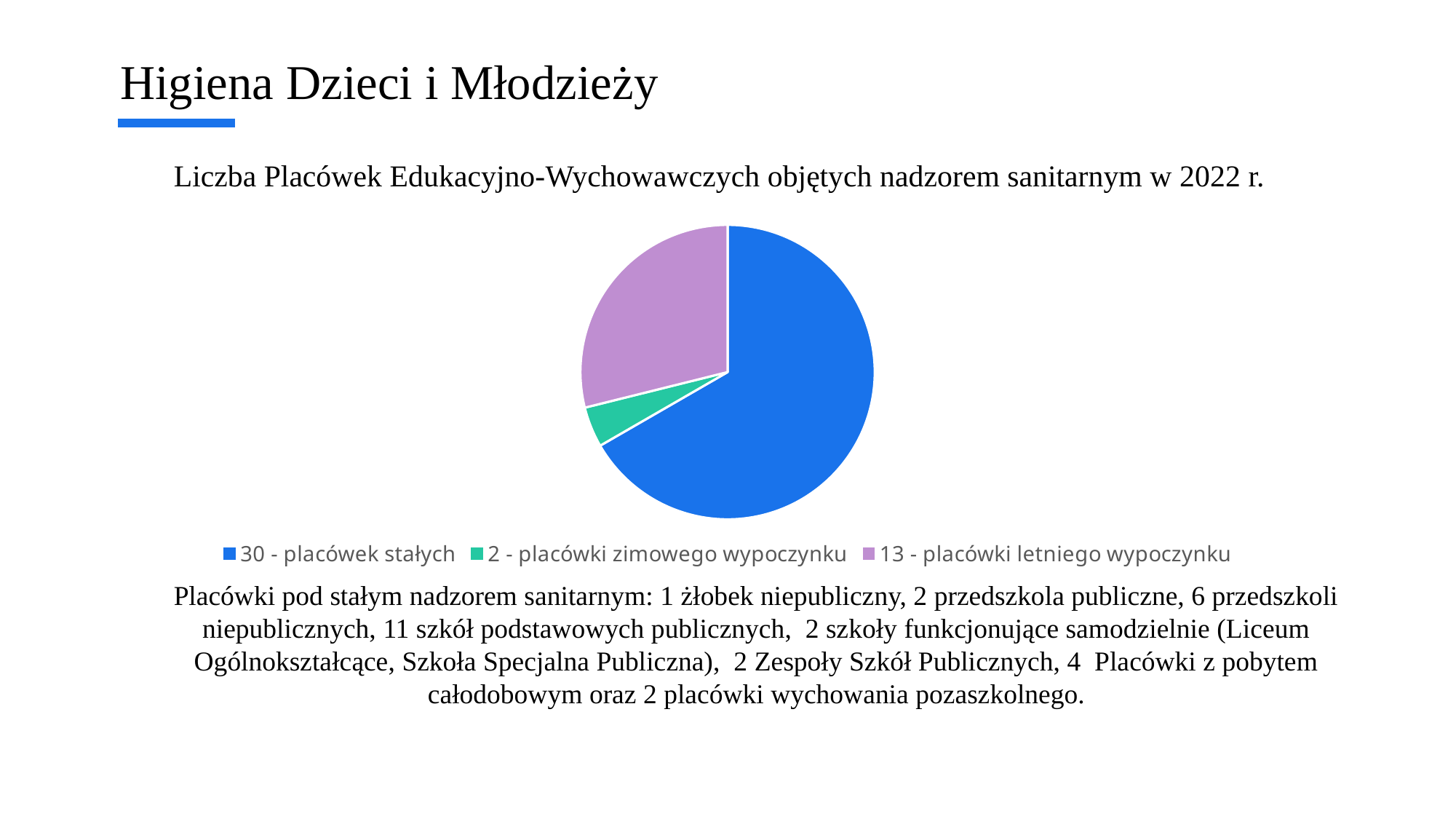
What is the total number of facilities represented in the pie chart? 45 According to the legend, how many 'placówek stałych' are there? 30 Which is larger: placówki letniego wypoczynku or placówki zimowego wypoczynku? placówki letniego wypoczynku According to the legend, how many 'placówki zimowego wypoczynku' are there? 2 According to the legend, how many 'placówki letniego wypoczynku' are there? 13 Which category has the smallest slice of the pie chart? placówki zimowego wypoczynku How many entries does the legend of the pie chart list? 3 Which category has the largest slice of the pie chart? placówek stałych What type of chart is shown on the slide? Pie chart What colour is the slice for placówki letniego wypoczynku? Purple What is the difference between the number of placówek stałych and placówki letniego wypoczynku? 17 How many slices does the pie chart have? 3